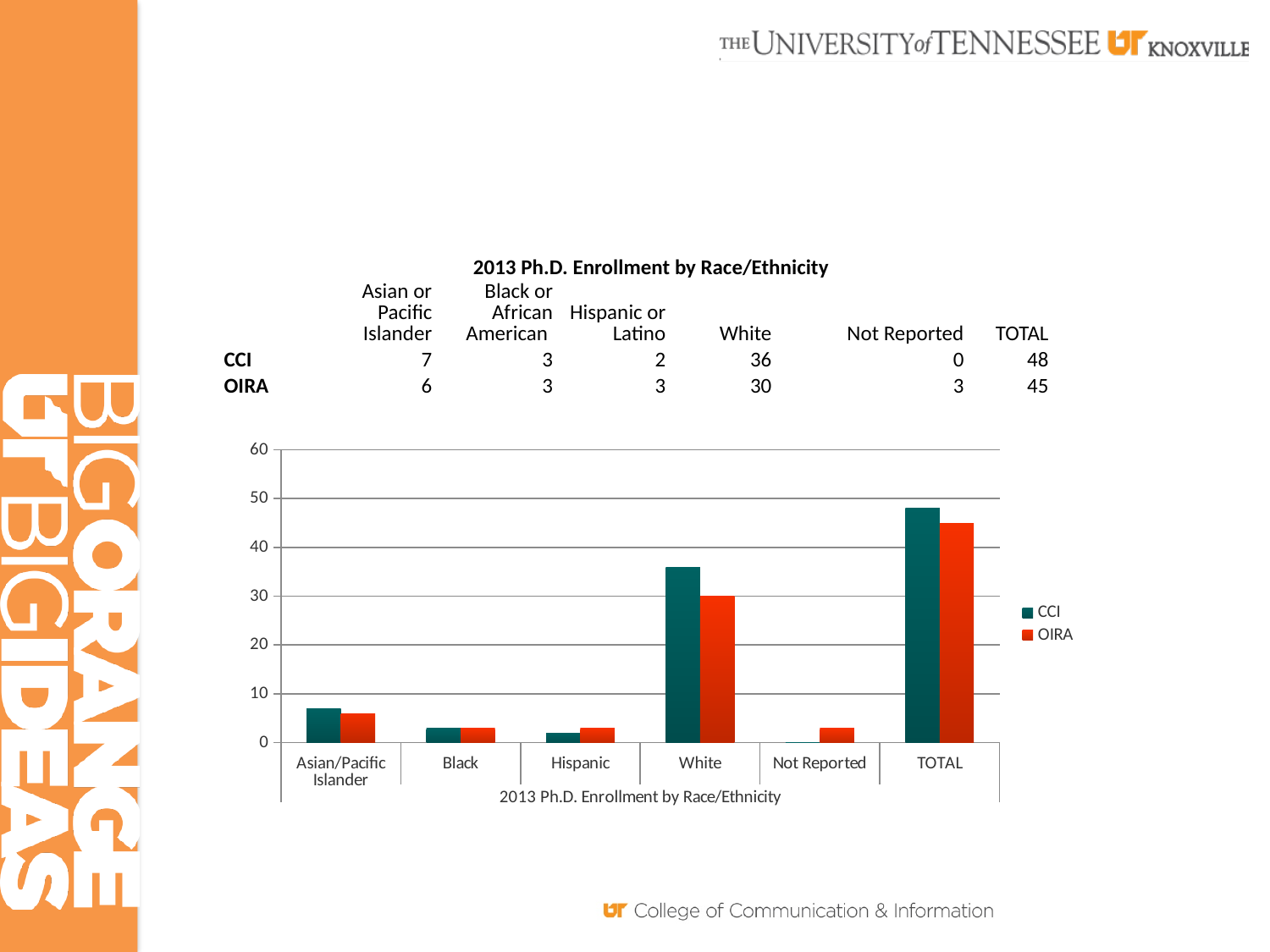
Which is larger for Hispanic, the CCI value or the OIRA value? OIRA What is the difference between the CCI and OIRA values for White? 6 How many categories are shown along the x axis of the chart? 6 What is the OIRA value for Not Reported? 3 Which category has the highest OIRA value? TOTAL What is the CCI value for White? 36 Which category has the lowest CCI value? Not Reported What is the CCI value for TOTAL? 48 What kind of chart is shown on the slide? bar chart What is the title shown below the x axis of the chart? 2013 Ph.D. Enrollment by Race/Ethnicity How many series does the chart legend list? 2 Is the OIRA value for White greater or less than 20? greater